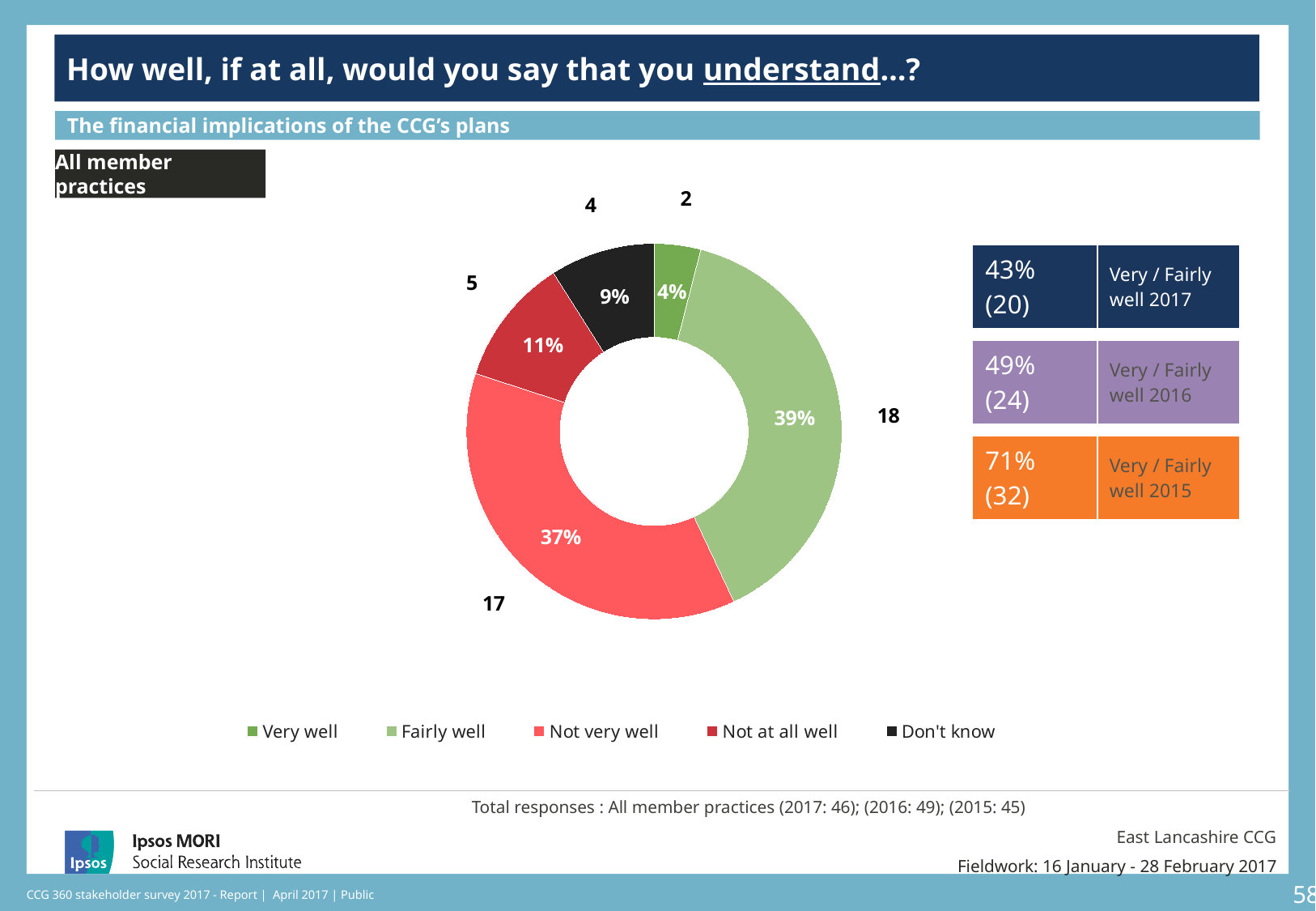
Which response category has the largest share of the donut chart? Fairly well Which is larger: the share for 'Don't know' or the share for 'Very well'? Don't know Which response category has the smallest share of the donut chart? Very well What is the difference in percentage points between 'Not very well' and 'Not at all well'? 26 What percentage of respondents answered 'Not very well'? 37% How many respondents answered 'Not at all well'? 5 How many entries does the legend list? 5 What percentage of respondents said they understand the financial implications of the CCG's plans 'Fairly well'? 39% What kind of chart is used to show the responses? Donut (pie) chart What is the combined 'Very / Fairly well' percentage for 2017 shown in the box to the right of the chart? 43% What percentage of respondents answered 'Don't know'? 9% How many response categories are shown in the donut chart? 5